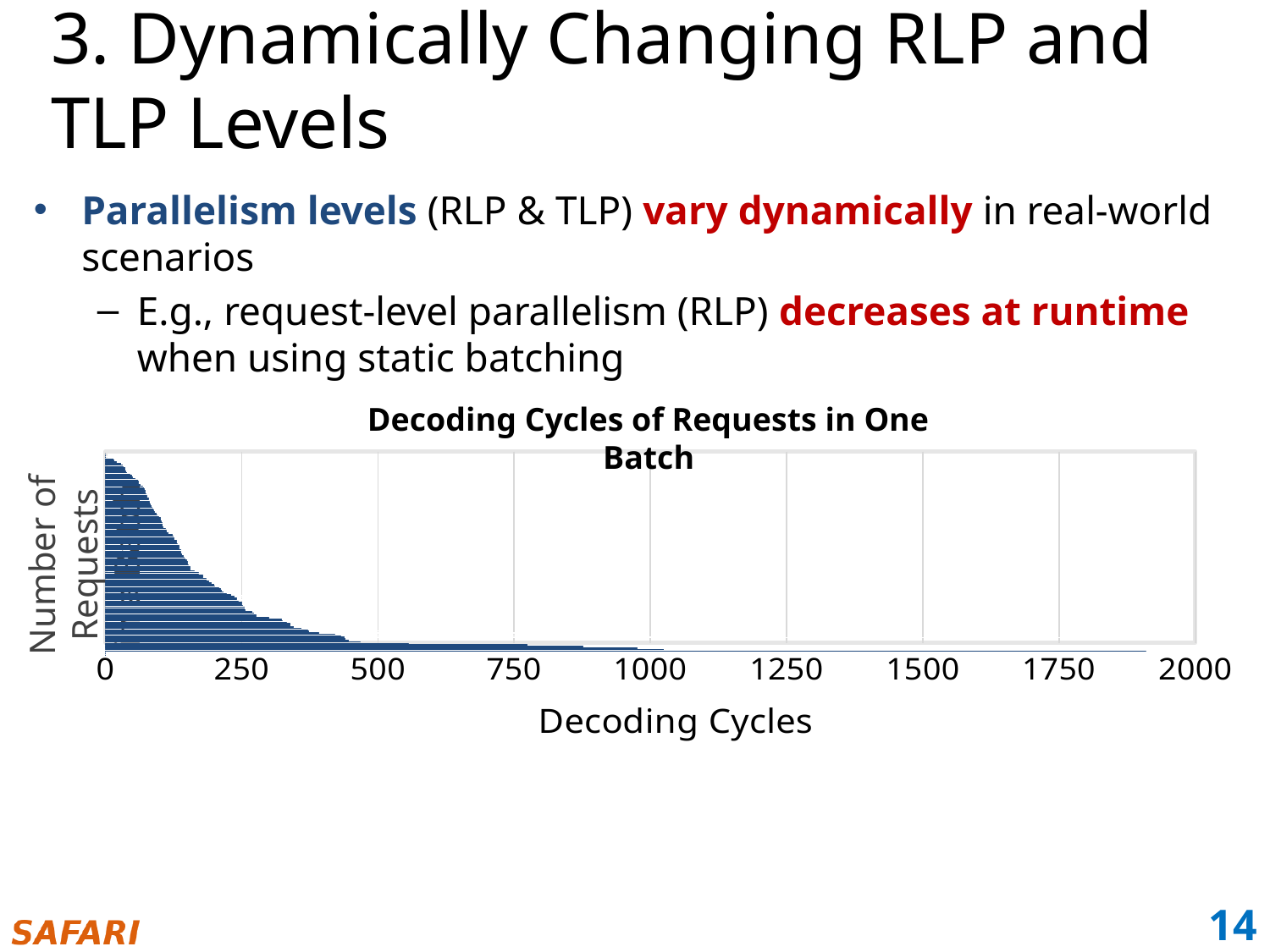
Is the value for the longest bar in the chart greater or less than 750? greater What is the label of the x axis of the chart? Decoding Cycles Is the value for the shortest bar at the top of the chart greater or less than 250? less What kind of chart is shown on the slide? bar chart What is the title of the chart? Decoding Cycles of Requests in One Batch Do the bars get longer or shorter moving from the top of the chart to the bottom? longer